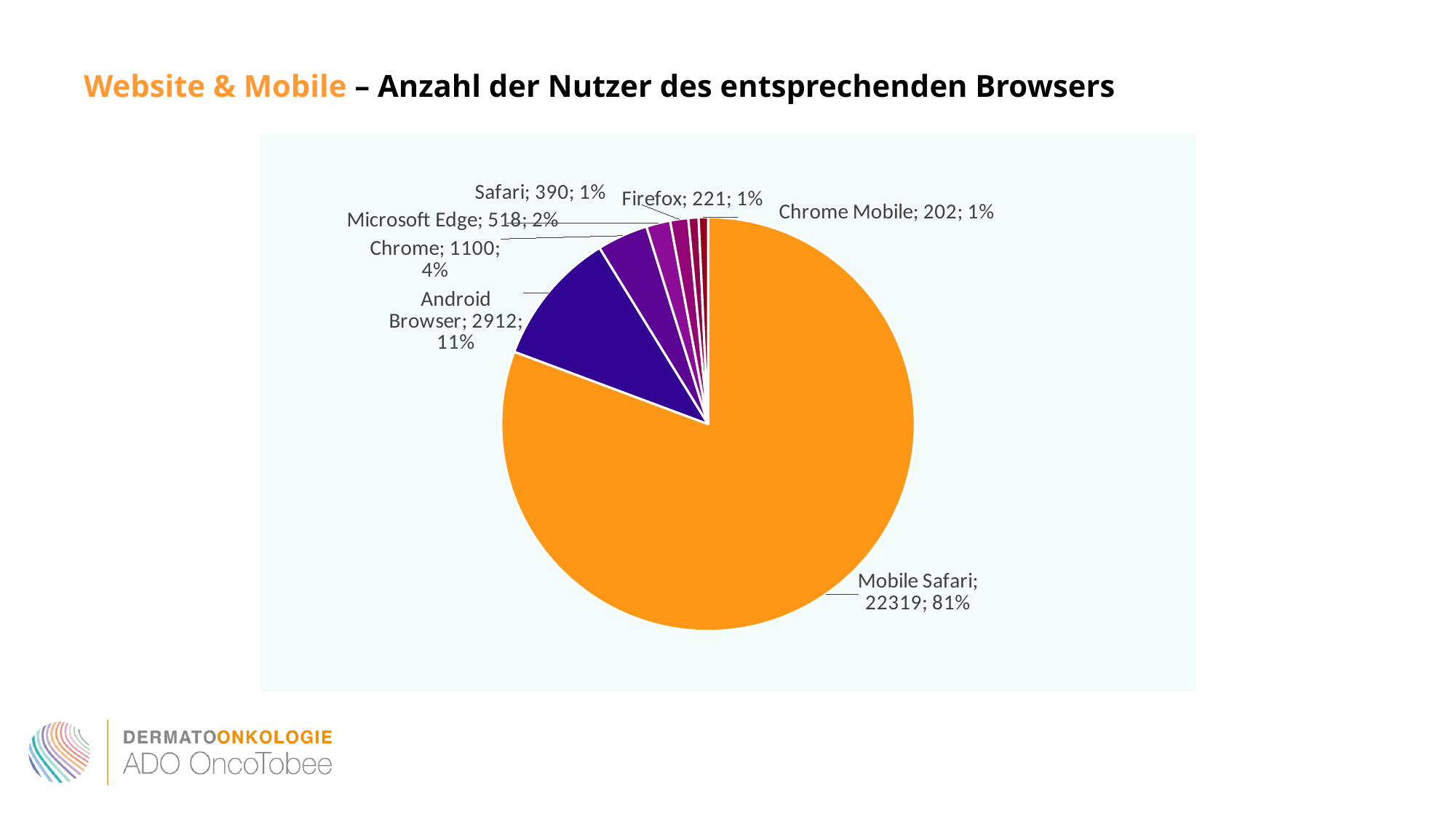
How many users does the chart show for Mobile Safari? 22319 How many users does the chart show for Firefox? 221 How many users does the chart show for Microsoft Edge? 518 What kind of chart is shown on the slide? pie chart How many browser categories does the pie chart show? 7 How many users does the chart show for Android Browser? 2912 What is the difference in users between Chrome and Microsoft Edge? 582 What share of the pie does Android Browser have? 11% Which browser has the smallest slice of the pie? Chrome Mobile Which browser has the largest slice of the pie? Mobile Safari Which has more users, Safari or Firefox? Safari What share of the pie does Chrome have? 4%